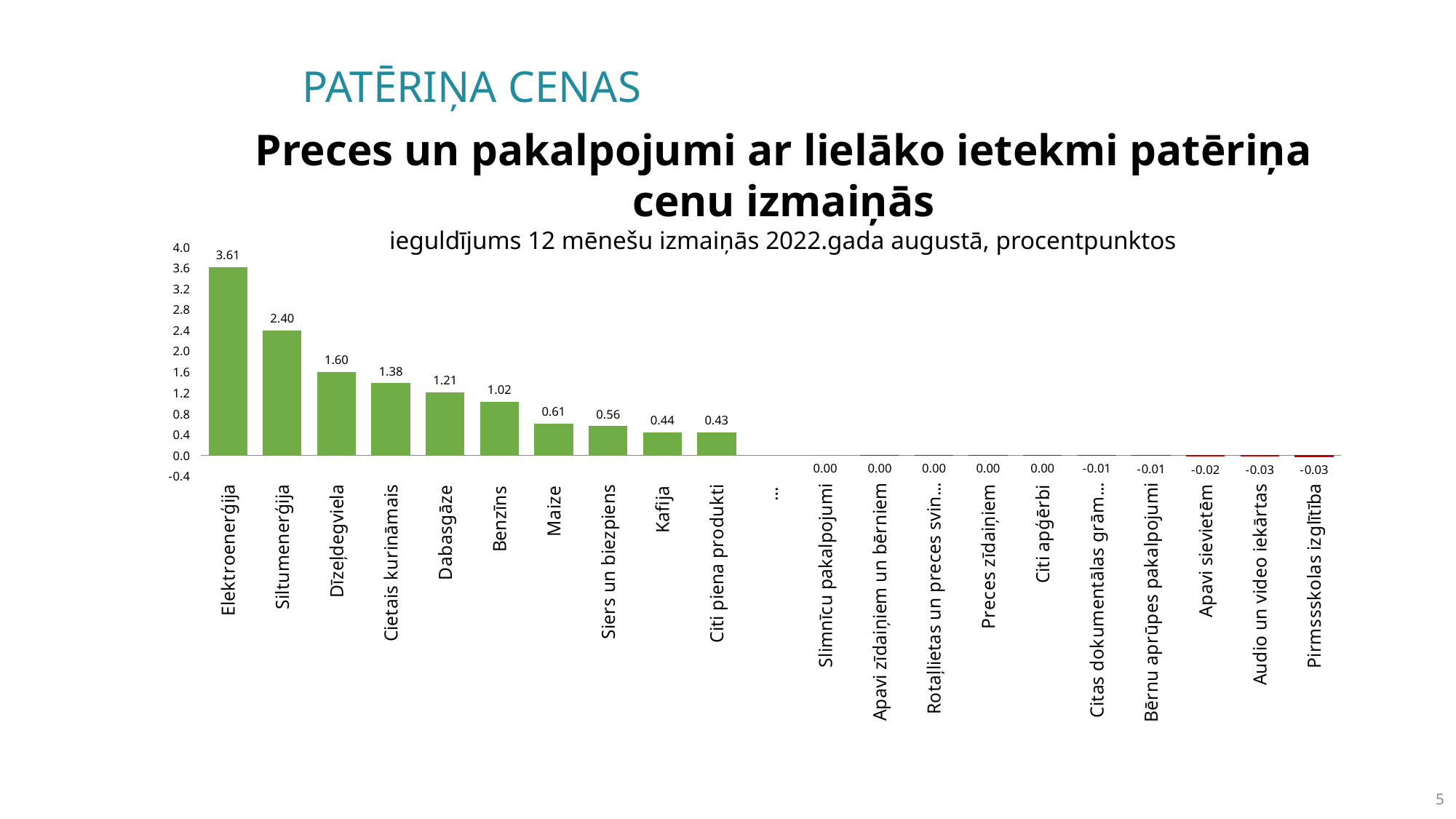
What kind of chart is shown on the slide? bar chart What is the difference between the values for Dīzeļdegviela and Cietais kurināmais? 0.22 What is the value for Elektroenerģija? 3.61 What is the value for Apavi sievietēm? -0.02 Which category has the highest value? Elektroenerģija Is the value for Siltumenerģija greater or less than 2.0? greater Which is larger, the value for Maize or the value for Siers un biezpiens? Maize What is the value for Dabasgāze? 1.21 What is the value for Kafija? 0.44 What is the difference between the values for Elektroenerģija and Siltumenerģija? 1.21 Do the values rise or fall from left to right along the x axis? fall What is the subtitle shown below the chart title? ieguldījums 12 mēnešu izmaiņās 2022.gada augustā, procentpunktos